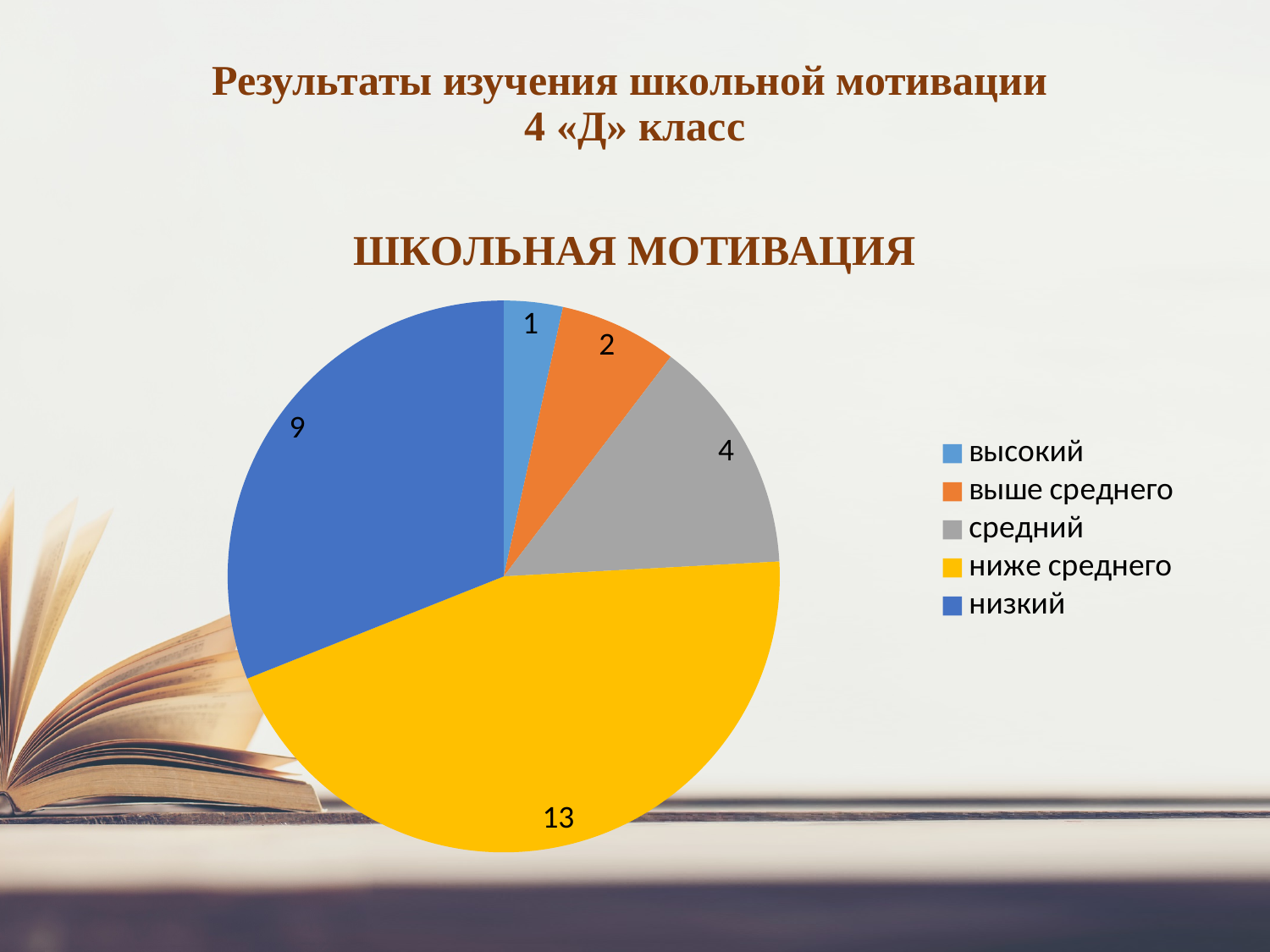
What is the difference between the values for 'ниже среднего' and 'низкий'? 4 What is the value for 'низкий'? 9 What kind of chart is shown on the slide? pie chart Which category has the smallest slice? высокий What is the title of the chart? ШКОЛЬНАЯ МОТИВАЦИЯ How many slices does the pie chart have? 5 What is the value for 'высокий'? 1 Which is larger, the value for 'средний' or the value for 'выше среднего'? средний How many entries does the legend list? 5 Which category has the largest slice? ниже среднего What is the value for 'средний'? 4 What is the value for 'ниже среднего'? 13